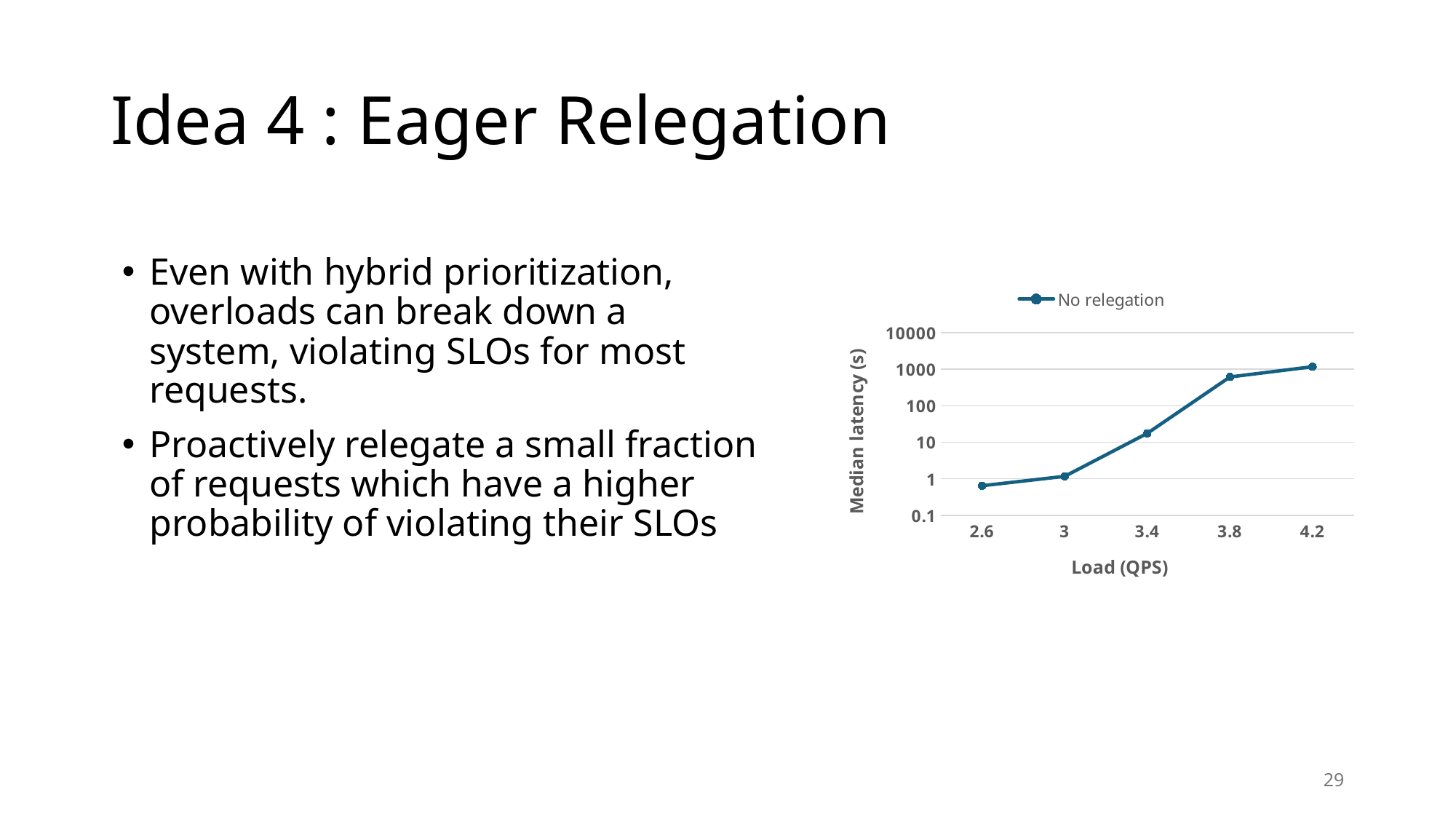
What is the name of the series shown in the chart's legend? No relegation Is the median latency at a load of 2.6 QPS greater or less than 1? less Is the median latency at a load of 3.8 QPS greater or less than 1000? less Does the median latency rise or fall as load increases along the x axis? rise How many data points are plotted on the line? 5 Which has the higher median latency: a load of 3.4 QPS or 3.8 QPS? 3.8 What kind of chart is shown on the slide? line chart Is the median latency at a load of 3.4 QPS greater or less than 10? greater How many series does the chart's legend list? 1 At which load (QPS) is the median latency lowest? 2.6 At which load (QPS) is the median latency highest? 4.2